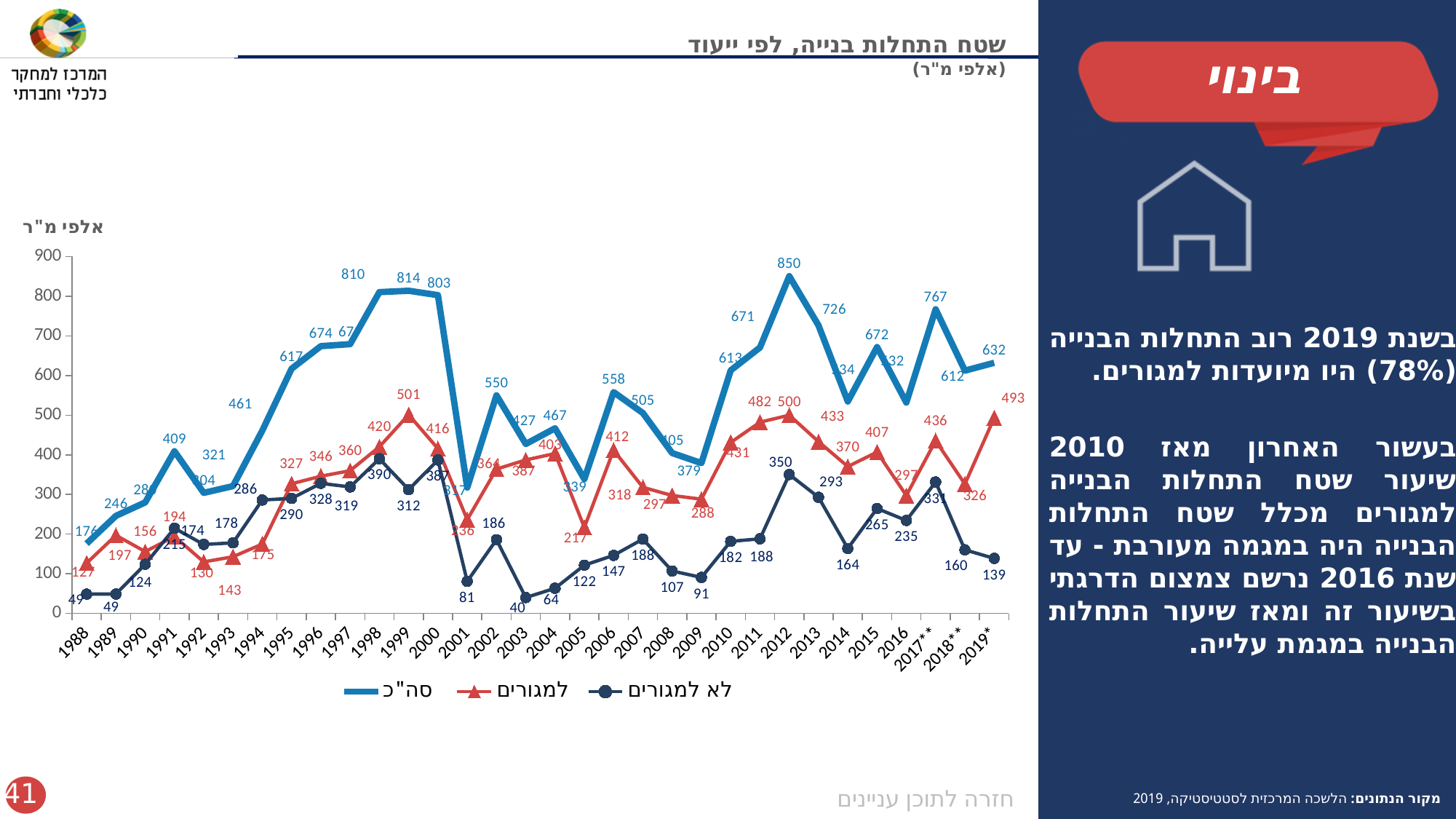
What is the difference between the למגורים and לא למגורים values in 2019? 354 In which year is the לא למגורים (non-residential) series at its lowest? 2003 What is the value of the למגורים (residential) series for 2019? 493 What type of chart is shown on the slide? line chart In 2012, which is larger: the למגורים value or the לא למגורים value? למגורים In which year does the סה"כ (total) series reach its highest value? 2012 In which year does the למגורים (residential) series reach its highest value? 1999 How many years are shown on the x axis? 32 Does the סה"כ (total) series rise or fall from 2016 to 2017? rise What is the value of the סה"כ (total) series for 2019? 632 What is the value of the לא למגורים (non-residential) series for 2003? 40 How many series does the legend list? 3